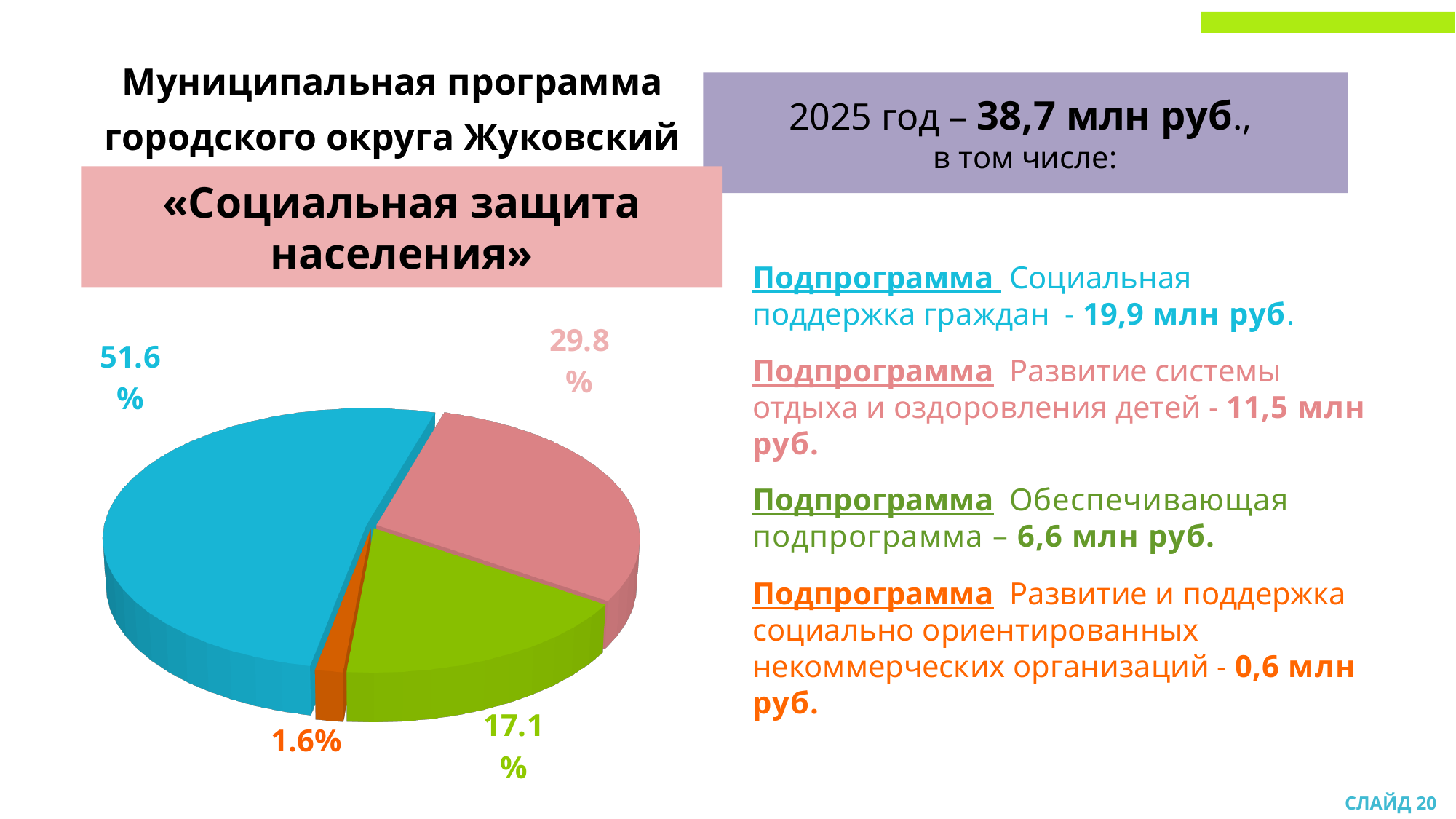
What percentage is shown for the green slice of the pie chart? 17.1% Which slice of the pie chart has the smallest share? the orange slice (1.6%) What percentage is shown for the blue slice of the pie chart? 51.6% What percentage is shown for the orange slice of the pie chart? 1.6% What kind of chart is shown on the slide? pie chart What is the difference in percentage points between the blue slice and the pink slice? 21.8 Which slice of the pie chart has the largest share? the blue slice (51.6%) Which is larger in the pie chart, the pink slice or the green slice? the pink slice How many slices does the pie chart have? 4 What is the total amount for the programme in 2025 stated on the slide? 38,7 млн руб. What is the combined share of the green and orange slices of the pie chart? 18.7% What percentage is shown for the pink slice of the pie chart? 29.8%